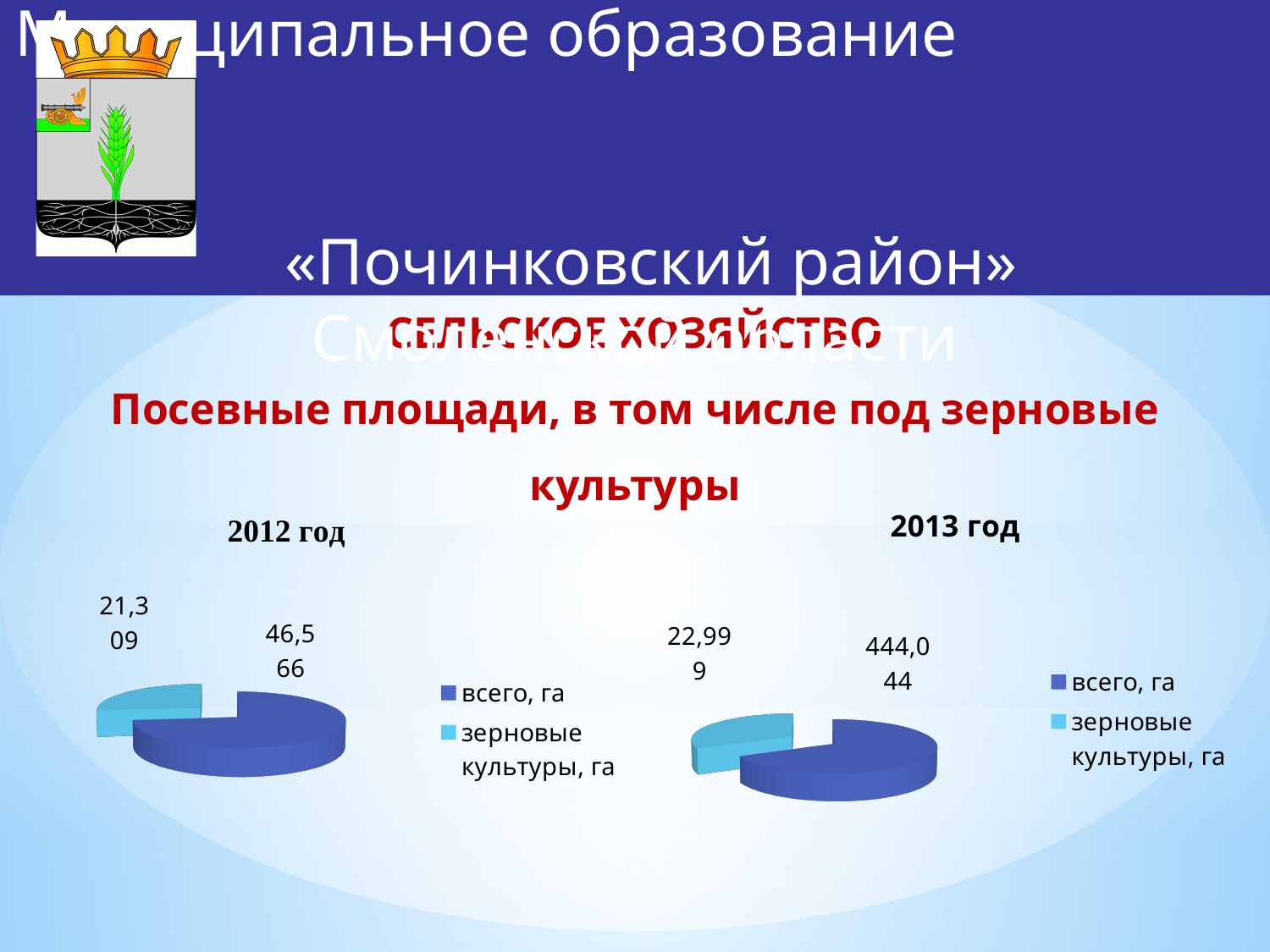
In the "2012 год" chart, which slice is the largest? всего, га Which year has the larger value for "зерновые культуры, га", 2012 or 2013? 2013 What is the title of the "2013 год" chart? 2013 год In the "2012 год" chart, what is the value for "зерновые культуры, га"? 21,309 In the "2012 год" chart, what is the value for "всего, га"? 46,566 In the "2013 год" chart, which slice is the smallest? зерновые культуры, га In the "2013 год" chart, what is the value for "зерновые культуры, га"? 22,999 How many charts are shown on the slide? 2 What kind of chart is the "2012 год" chart? pie chart How many slices does the "2012 год" pie chart have? 2 In the "2012 год" chart, what is the difference between "всего, га" and "зерновые культуры, га"? 25,257 How many entries does the legend of the "2013 год" chart list? 2